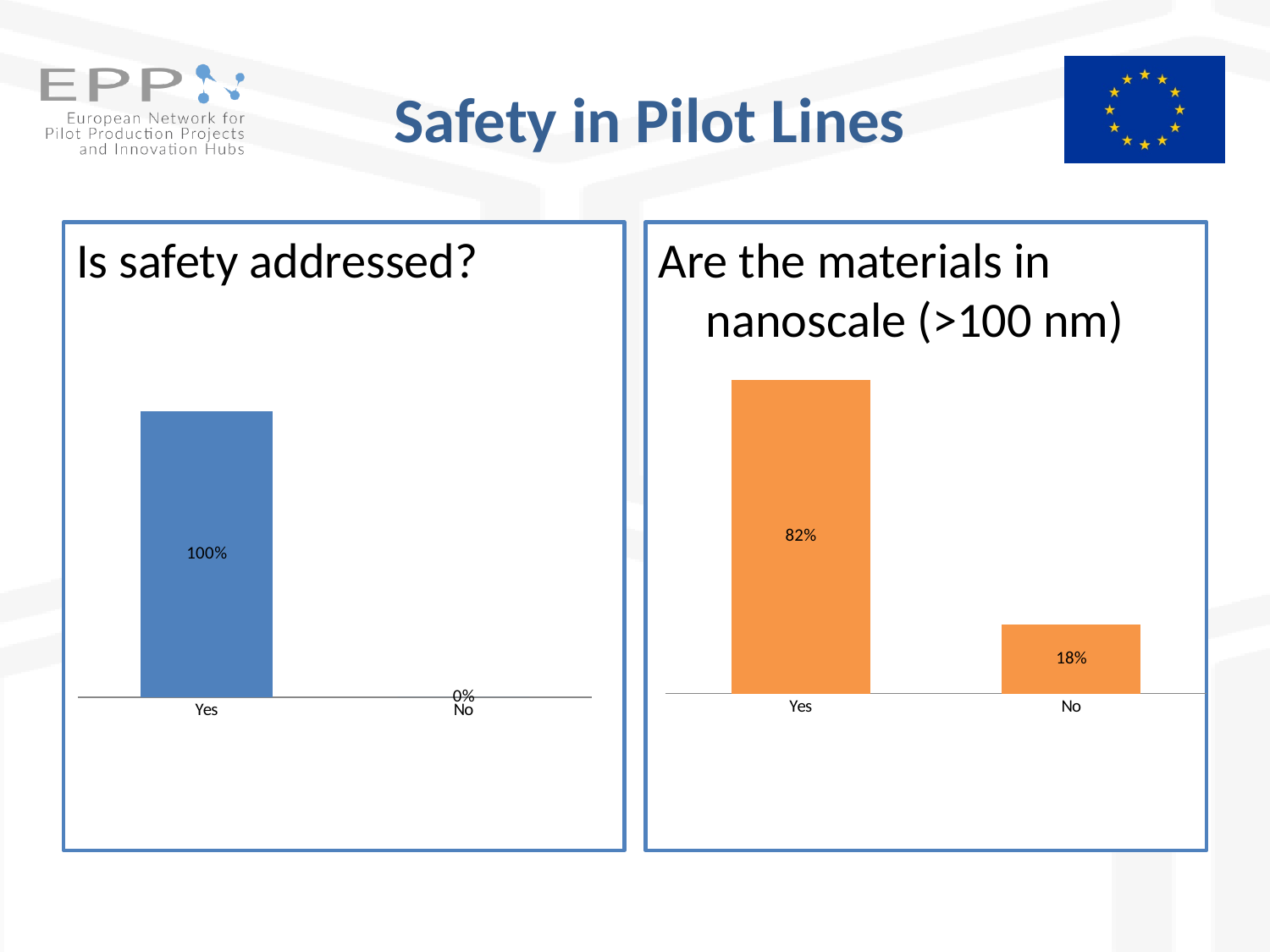
In the 'Are the materials in nanoscale (>100 nm)' chart, which category has the highest value? Yes What kind of chart is the 'Is safety addressed?' chart? Bar chart In the 'Are the materials in nanoscale (>100 nm)' chart, what is the difference between the Yes and No values? 64% In the 'Are the materials in nanoscale (>100 nm)' chart, what is the value for No? 18% In the 'Is safety addressed?' chart, what is the value for No? 0% In the 'Is safety addressed?' chart, which category has the lowest value? No In the 'Are the materials in nanoscale (>100 nm)' chart, which is larger, Yes or No? Yes In the 'Is safety addressed?' chart, what is the value for Yes? 100% In the 'Are the materials in nanoscale (>100 nm)' chart, what is the value for Yes? 82% What colour are the bars in the 'Are the materials in nanoscale (>100 nm)' chart? Orange In the 'Is safety addressed?' chart, what is the difference between the Yes and No values? 100% How many categories does the 'Are the materials in nanoscale (>100 nm)' chart show? 2